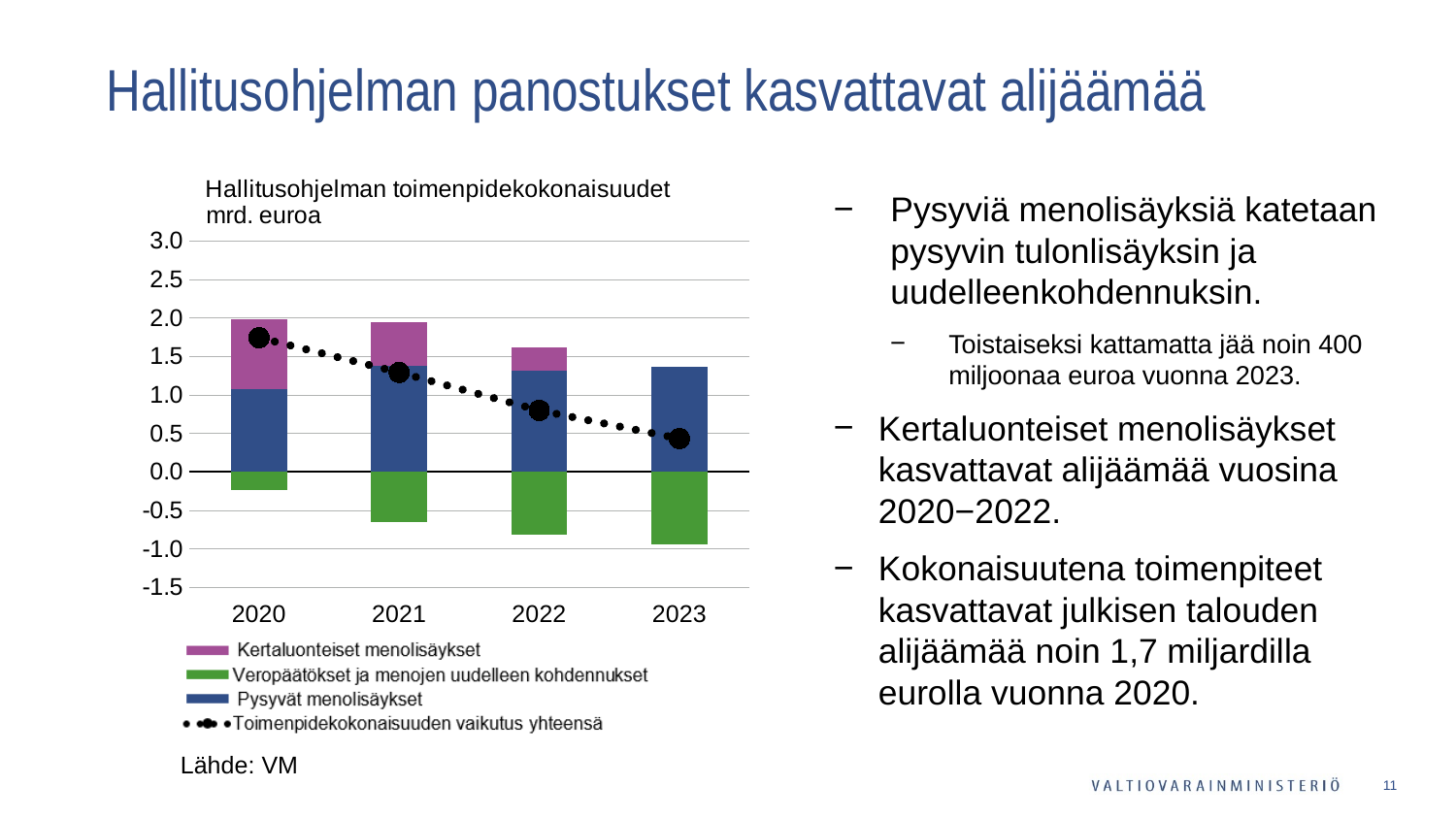
How many years are shown on the x axis of the chart? 4 Does the 'Toimenpidekokonaisuuden vaikutus yhteensä' line rise or fall from 2020 to 2023? Fall Is the value of the 'Toimenpidekokonaisuuden vaikutus yhteensä' line in 2023 greater or less than 1.0? less Is the 'Veropäätökset ja menojen uudelleen kohdennukset' value in 2023 greater or less than -0.5? less How many series does the chart legend list? 4 What kind of chart is shown on the slide? Bar chart with a line Is the value of the 'Toimenpidekokonaisuuden vaikutus yhteensä' line in 2020 greater or less than 1.5? greater In which year is the 'Toimenpidekokonaisuuden vaikutus yhteensä' line at its lowest? 2023 In which year is the 'Toimenpidekokonaisuuden vaikutus yhteensä' line at its highest? 2020 What is the title of the chart? Hallitusohjelman toimenpidekokonaisuudet mrd. euroa What source is given for the chart? VM In which year is the 'Kertaluonteiset menolisäykset' segment the largest? 2020